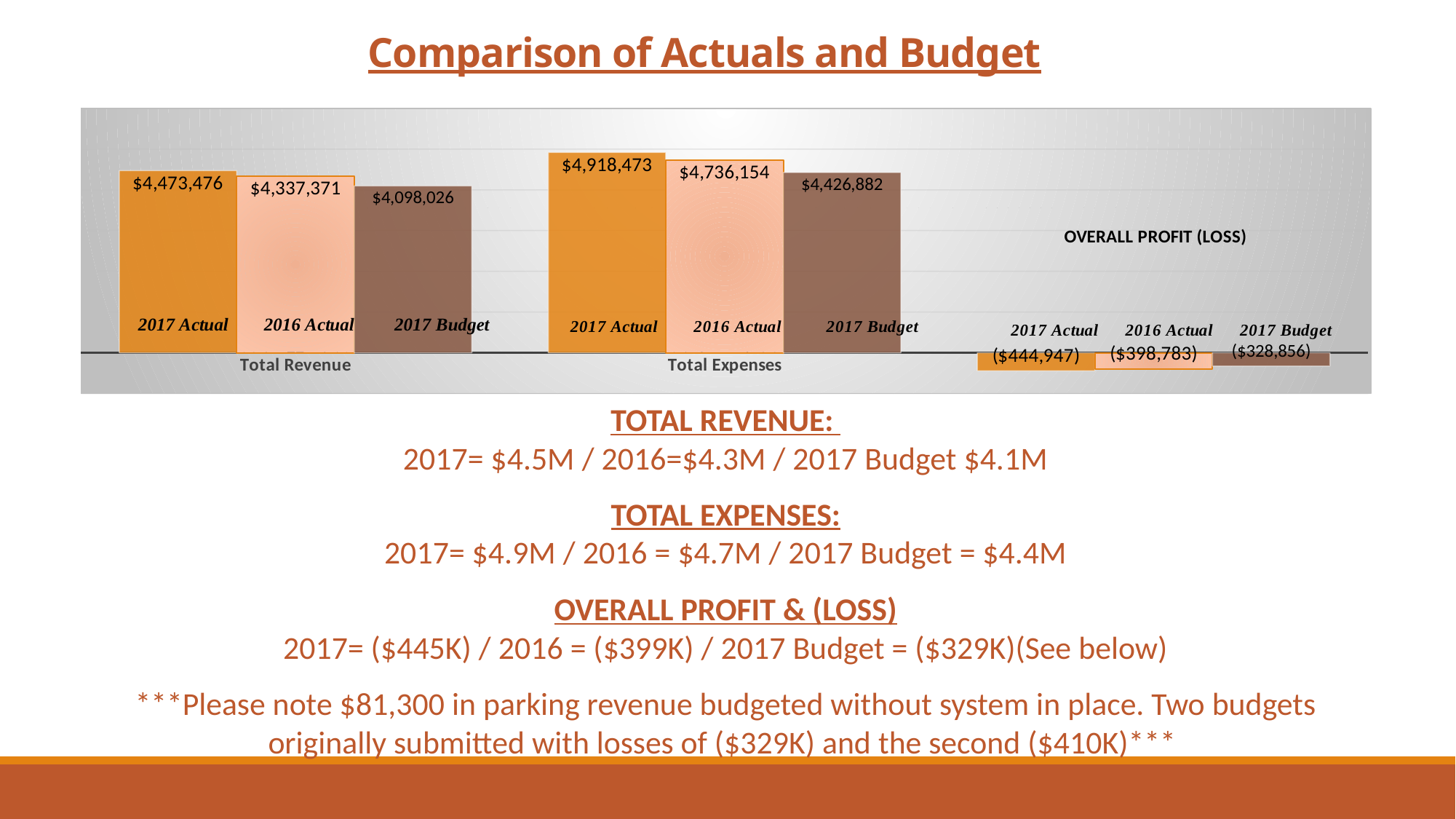
What kind of chart is shown on the slide? Bar chart What is the difference between the 2017 Actual and 2017 Budget values for Total Revenue? $375,450 What is the 2017 Budget value for Overall Profit (Loss)? ($328,856) What is the 2017 Actual value for Total Revenue? $4,473,476 Which series has the lowest value for Total Revenue? 2017 Budget What is the 2017 Budget value for Total Revenue? $4,098,026 How many categories are shown on the x axis of the chart? 3 What is the 2016 Actual value for Total Expenses? $4,736,154 Which is larger: the 2017 Actual value for Total Revenue or the 2017 Actual value for Total Expenses? Total Expenses What is the 2017 Actual value for Overall Profit (Loss)? ($444,947) Which series has the highest value for Total Expenses? 2017 Actual What is the difference between the 2017 Actual and 2016 Actual values for Total Expenses? $182,319